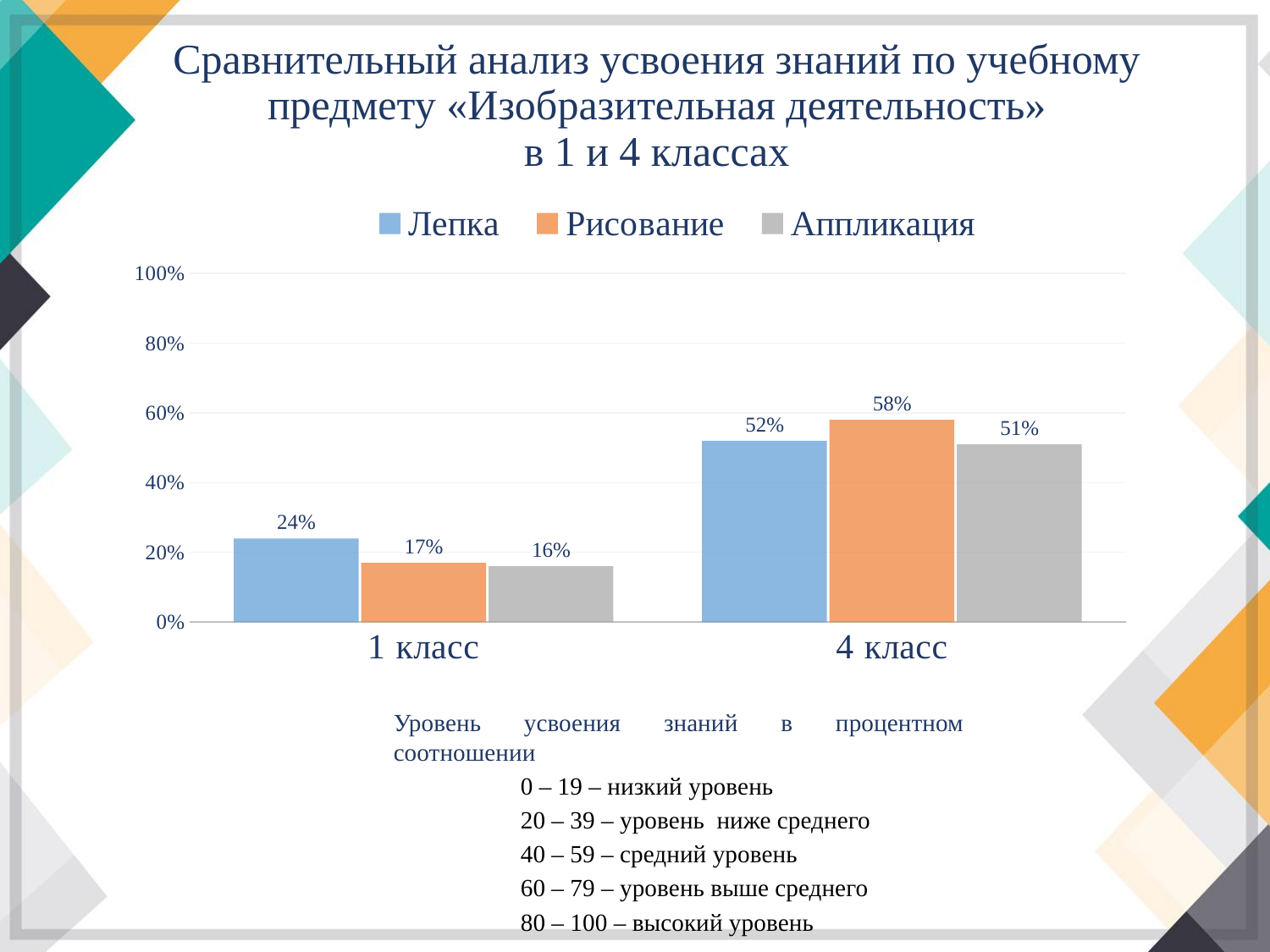
What is the value for Рисование in 4 класс? 58% Which series has the lowest value in 1 класс? Аппликация What is the value for Лепка in 1 класс? 24% What is the difference between the Лепка values for 4 класс and 1 класс? 28% Which colour represents Рисование in the legend? orange How many series does the legend list? 3 How many categories are shown on the x axis? 2 Which series has the highest value in 4 класс? Рисование What is the value for Аппликация in 1 класс? 16% What kind of chart is shown on the slide? bar chart Is the value for Аппликация in 4 класс greater or less than 40%? greater Which is larger: Рисование in 1 класс or Аппликация in 4 класс? Аппликация in 4 класс